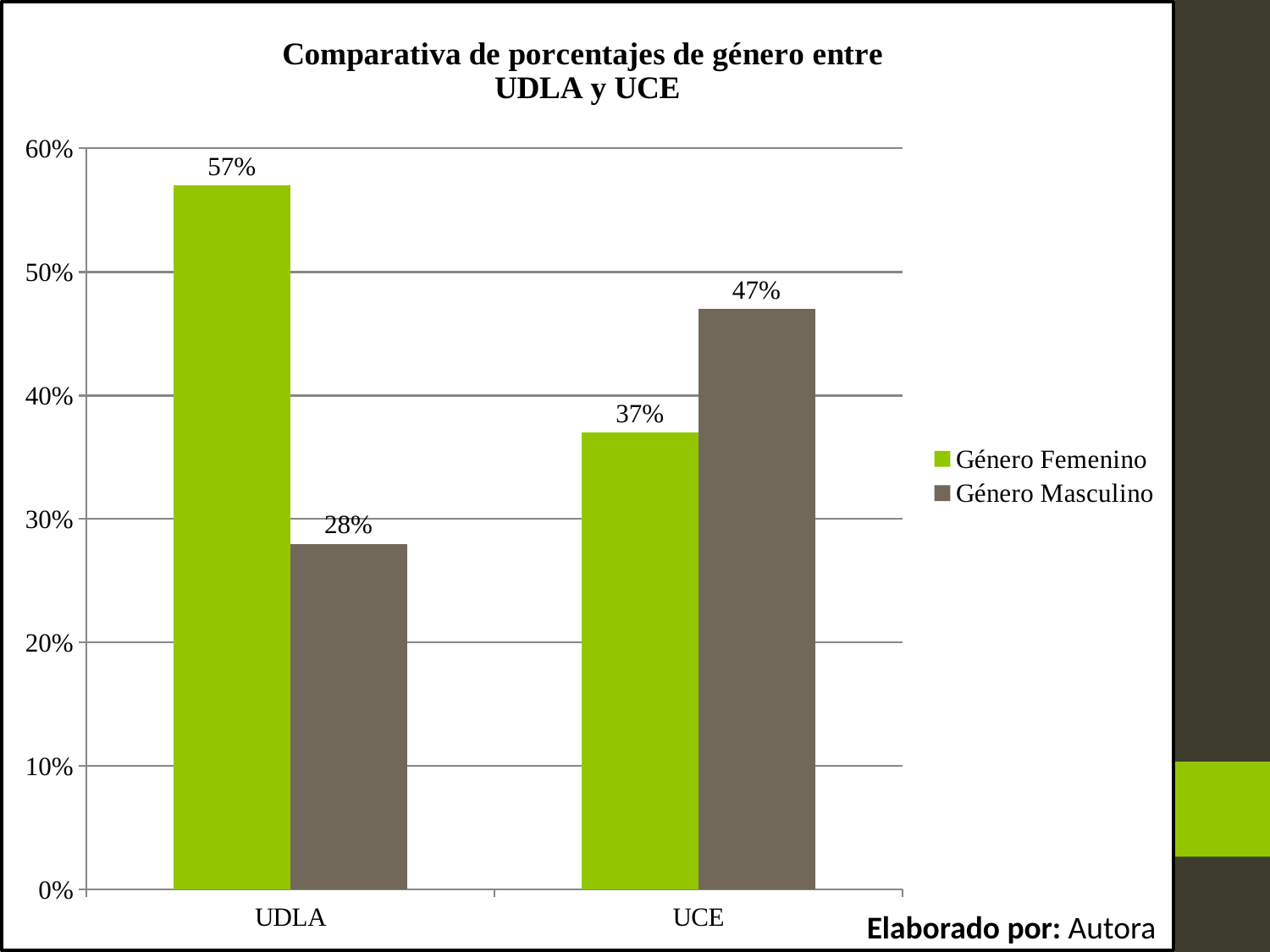
What is the value for Género Masculino at UCE? 47% What is the difference between Género Masculino and Género Femenino at UCE? 10% What is the difference between Género Femenino and Género Masculino at UDLA? 29% How many categories are shown on the x axis? 2 What kind of chart is shown on the slide? Bar chart Which is larger at UCE, Género Femenino or Género Masculino? Género Masculino What is the value for Género Masculino at UDLA? 28% How many series does the legend list? 2 Which university has the lowest value for Género Masculino? UDLA What is the value for Género Femenino at UDLA? 57% What is the value for Género Femenino at UCE? 37% Which university has the highest value for Género Femenino? UDLA